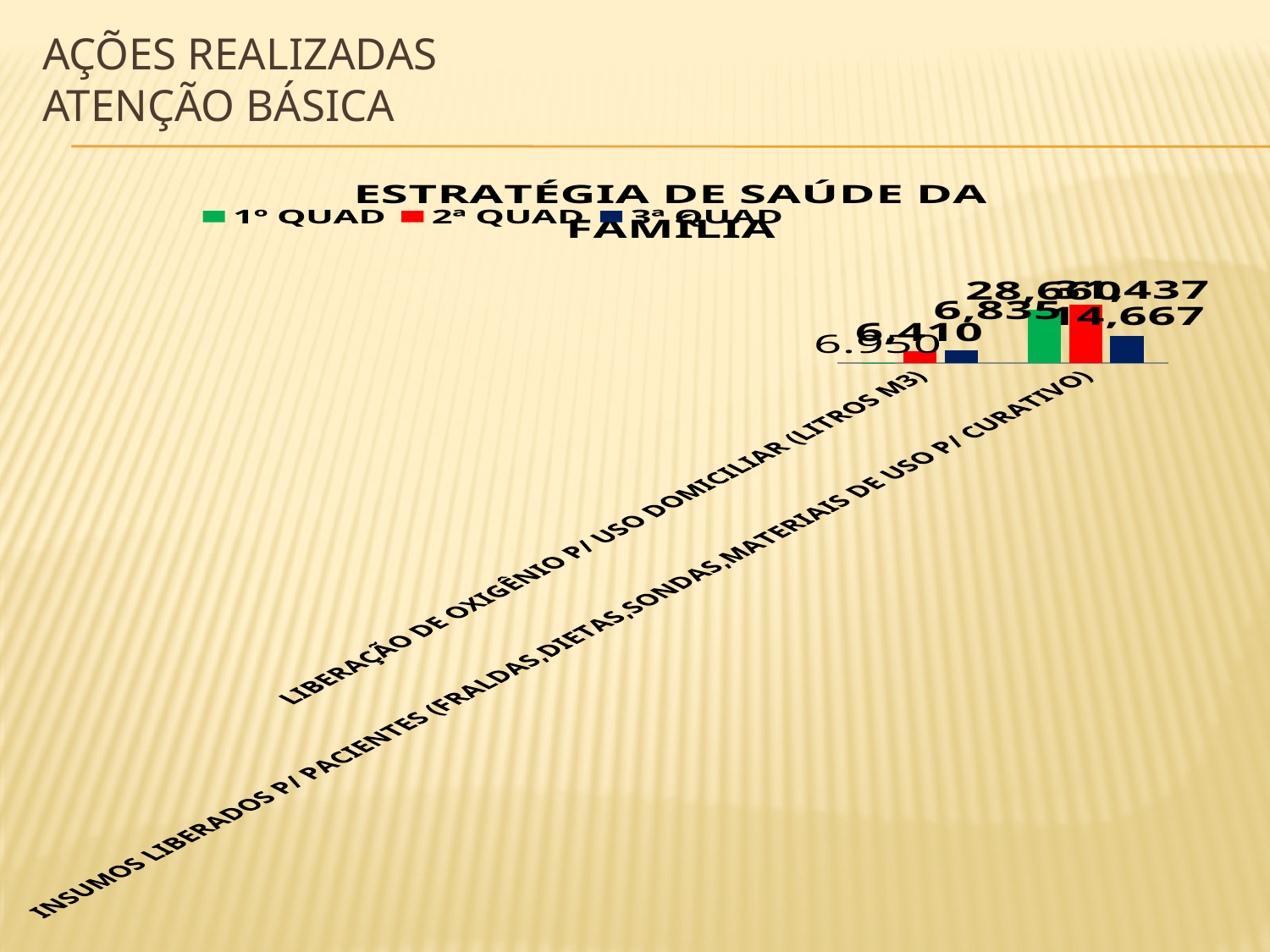
Which series are listed in the chart legend? 1º QUAD, 2ª QUAD, 3ª QUAD Which category has the higher 3ª QUAD value? INSUMOS LIBERADOS P/ PACIENTES (FRALDAS,DIETAS,SONDAS,MATERIAIS DE USO P/ CURATIVO) What is the 3ª QUAD value for LIBERAÇÃO DE OXIGÊNIO P/ USO DOMICILIAR (LITROS M3)? 6,835 For LIBERAÇÃO DE OXIGÊNIO P/ USO DOMICILIAR, which is larger: the 2ª QUAD value or the 3ª QUAD value? 3ª QUAD What is the 2ª QUAD value for LIBERAÇÃO DE OXIGÊNIO P/ USO DOMICILIAR (LITROS M3)? 6,410 What is the 3ª QUAD value for INSUMOS LIBERADOS P/ PACIENTES (FRALDAS,DIETAS,SONDAS,MATERIAIS DE USO P/ CURATIVO)? 14,667 How many categories are shown on the x axis of the chart? 2 What is the title of the chart? ESTRATÉGIA DE SAÚDE DA FAMÍLIA What kind of chart is shown on the slide? bar chart How many series does the chart legend list? 3 What is the difference between the 3ª QUAD and 2ª QUAD values for LIBERAÇÃO DE OXIGÊNIO P/ USO DOMICILIAR? 425 For INSUMOS LIBERADOS P/ PACIENTES, which series has the lowest value? 3ª QUAD